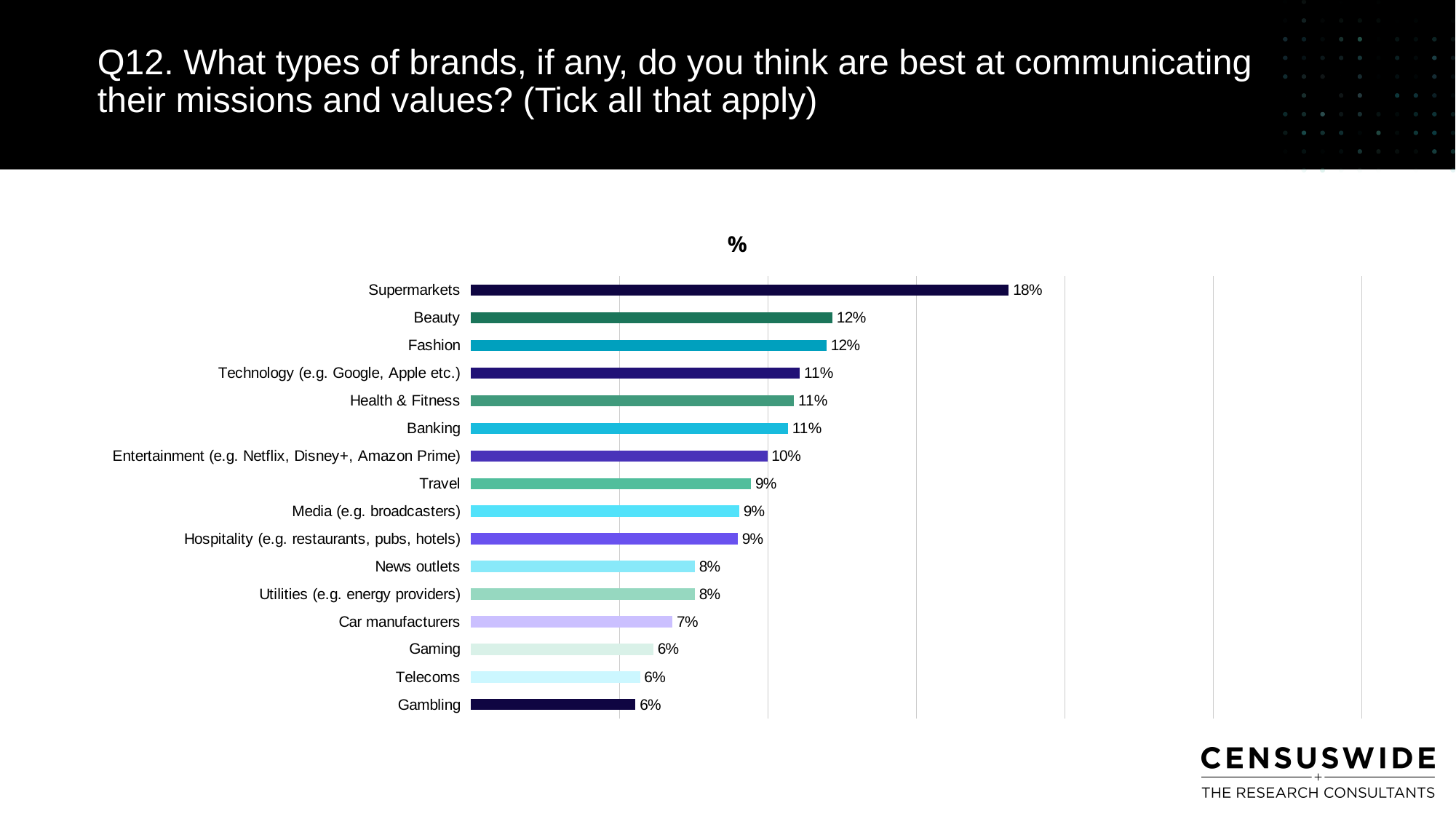
Which is larger, the value for Travel or the value for Gaming? Travel What is the difference between the values for Banking and Gambling? 5% What is the title of the chart? % What kind of chart is shown on the slide? Bar chart What is the difference between the values for Supermarkets and Beauty? 6% How many categories are shown in the chart? 16 What is the value for Supermarkets? 18% What is the value for Car manufacturers? 7% Which is larger, the value for Fashion or the value for News outlets? Fashion What is the value for Technology (e.g. Google, Apple etc.)? 11% Which category has the highest value? Supermarkets What is the value for Entertainment (e.g. Netflix, Disney+, Amazon Prime)? 10%